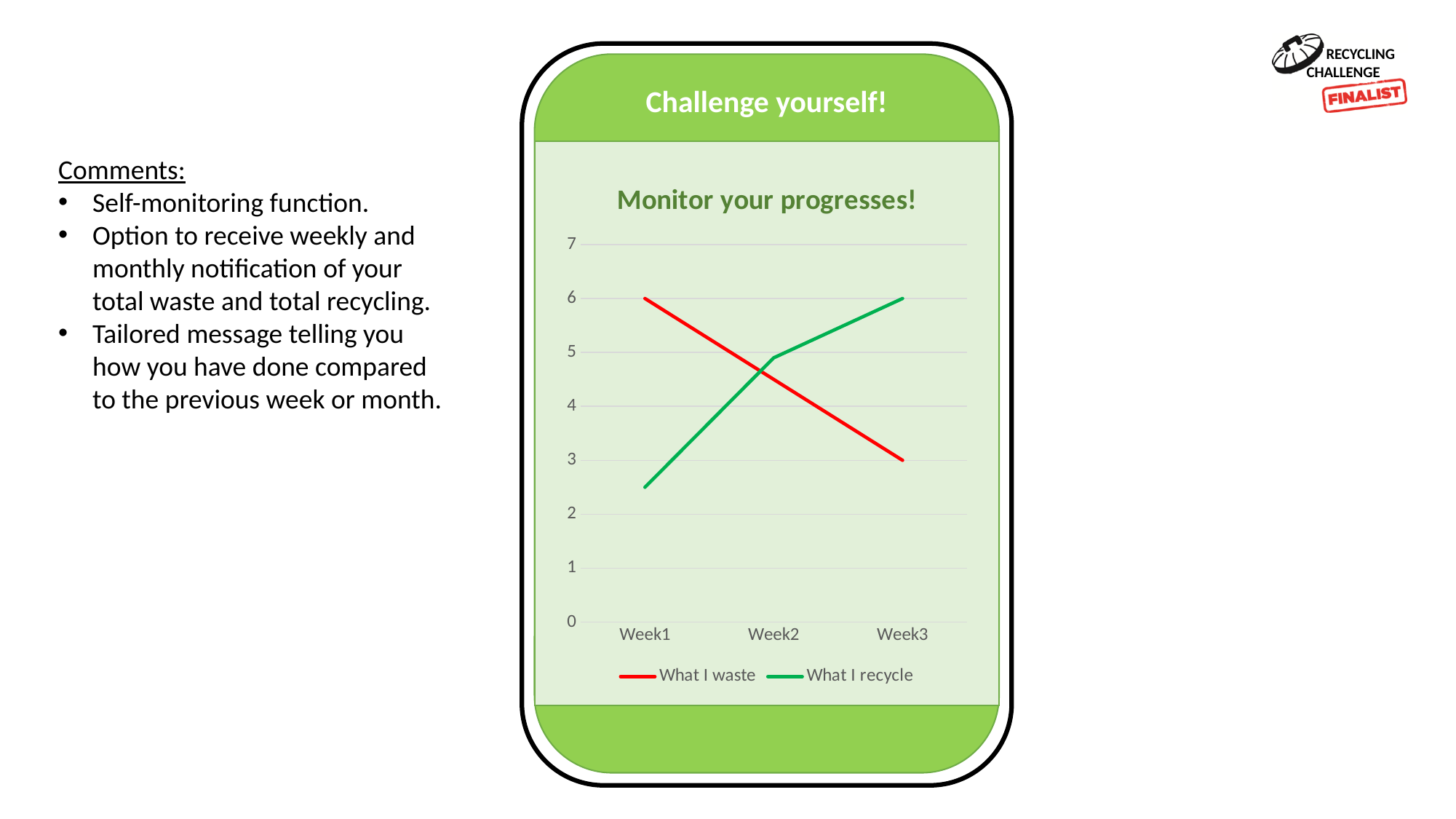
How many weeks are plotted on the x axis? 3 Is the value for 'What I recycle' in Week1 greater or less than 3? less What is the value of 'What I waste' in Week1? 6 What kind of chart is shown on the slide? Line chart Does the 'What I recycle' line rise or fall from Week1 to Week3? Rises What is the value of 'What I waste' in Week3? 3 By how much does 'What I waste' drop from Week1 to Week3? 3 In Week3, which series has the higher value, 'What I waste' or 'What I recycle'? What I recycle What is the title of the chart? Monitor your progresses! What is the value of 'What I recycle' in Week3? 6 How many series does the legend list? 2 Is the value for 'What I waste' in Week2 greater or less than 4? greater